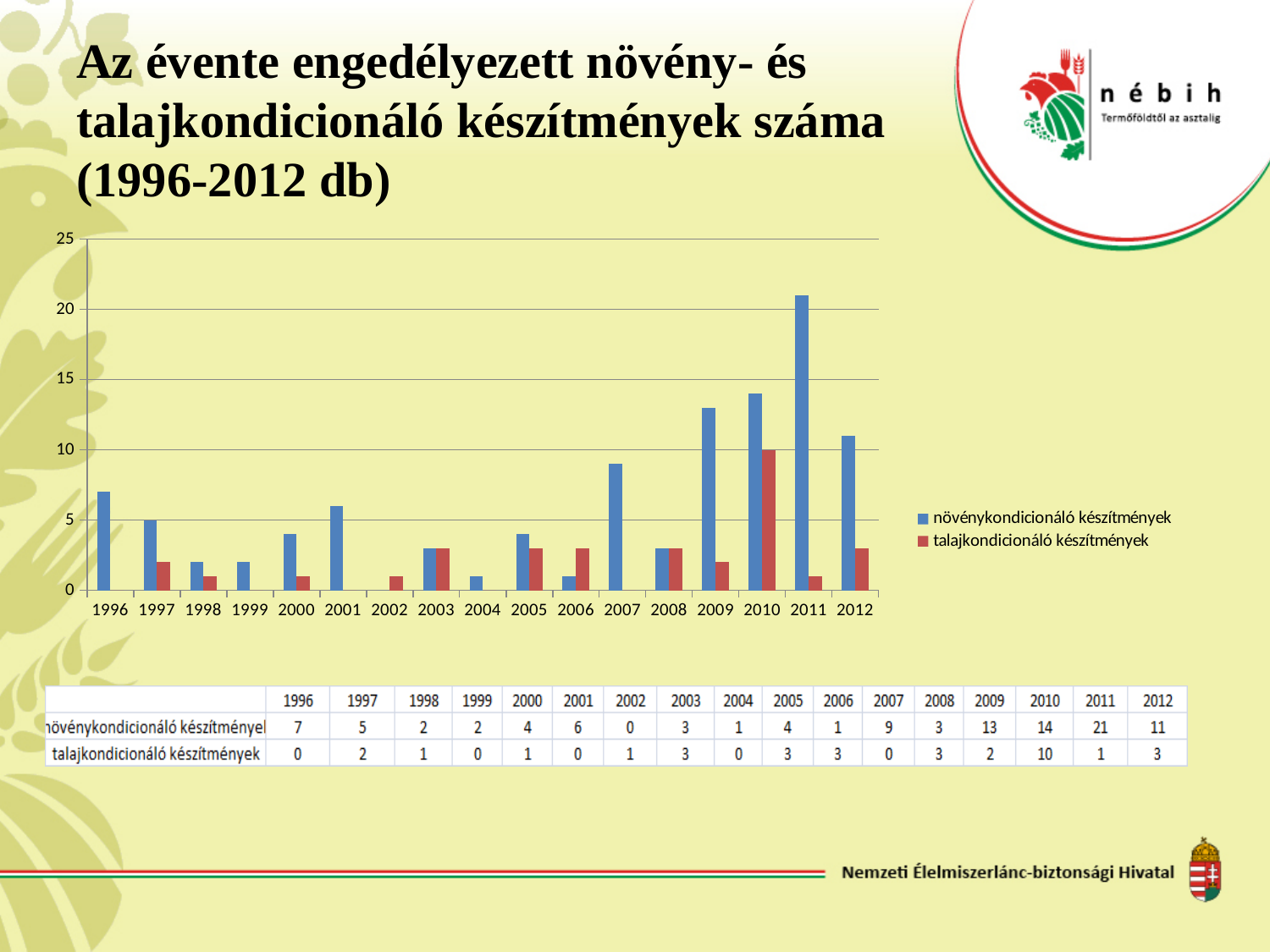
What is the value for növénykondicionáló készítmények in 2011? 21 Is the value for növénykondicionáló készítmények in 2011 greater or less than 20? greater What is the value for talajkondicionáló készítmények in 2010? 10 What is the difference between növénykondicionáló készítmények and talajkondicionáló készítmények in 2010? 4 What kind of chart is shown on the slide? bar chart How many years are shown on the x axis of the chart? 17 In which year is the value for talajkondicionáló készítmények highest? 2010 In which year is the value for növénykondicionáló készítmények highest? 2011 What is the value for növénykondicionáló készítmények in 1996? 7 Which colour represents talajkondicionáló készítmények in the chart? red Which is larger in 2006, növénykondicionáló készítmények or talajkondicionáló készítmények? talajkondicionáló készítmények How many series does the legend list? 2